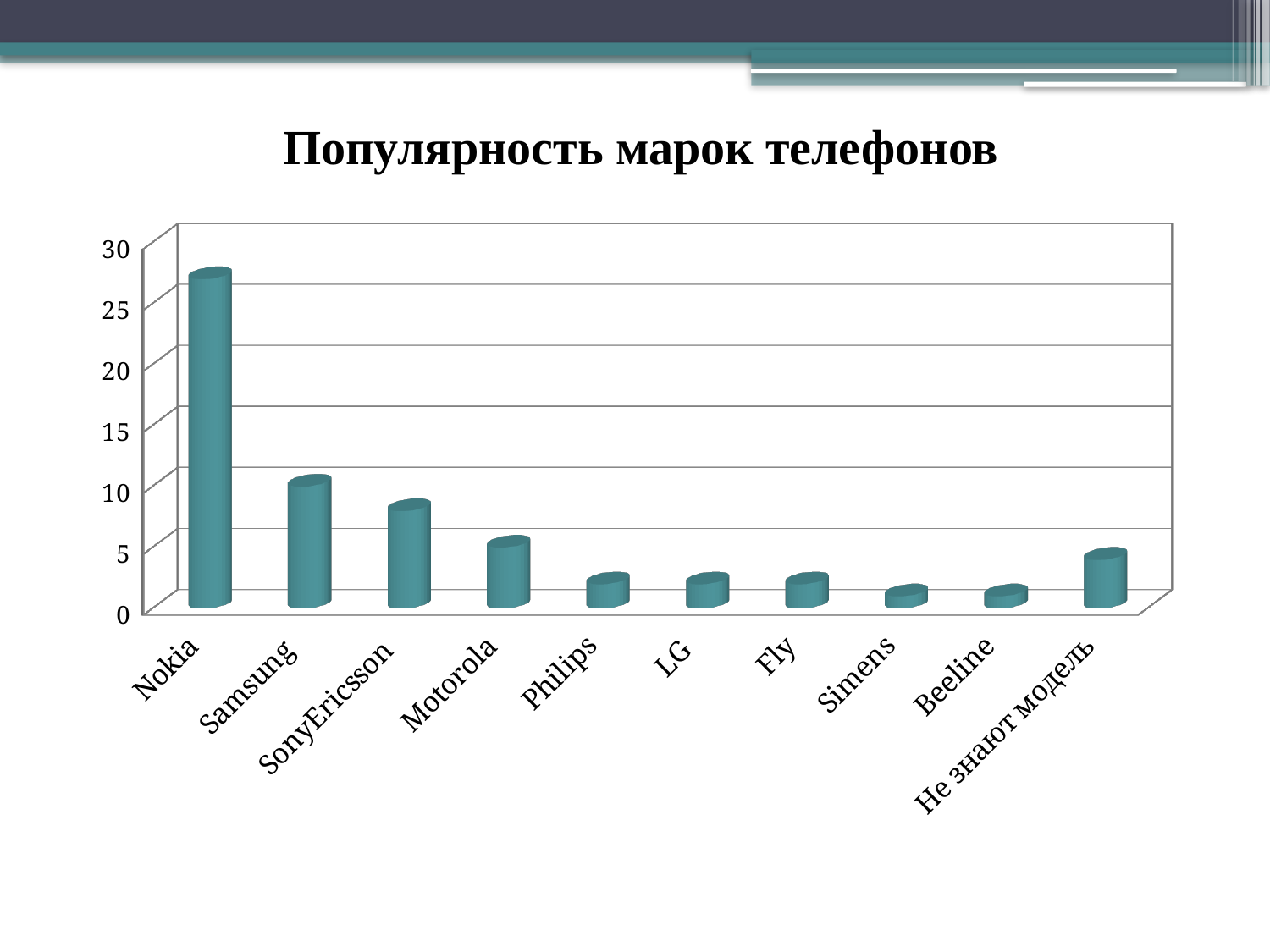
Which is larger, the value for Motorola or the value for Philips? Motorola What kind of chart is shown on the slide? bar chart How many phone brand categories are shown on the x axis? 10 Is the value for SonyEricsson greater or less than 10? less Which is larger, the value for Samsung or the value for SonyEricsson? Samsung Which category has the highest bar? Nokia Is the value for Nokia greater or less than 25? greater Is the value for Philips greater or less than 5? less Do the values generally rise or fall along the x axis from Nokia to Beeline? fall What is the title of the chart? Популярность марок телефонов